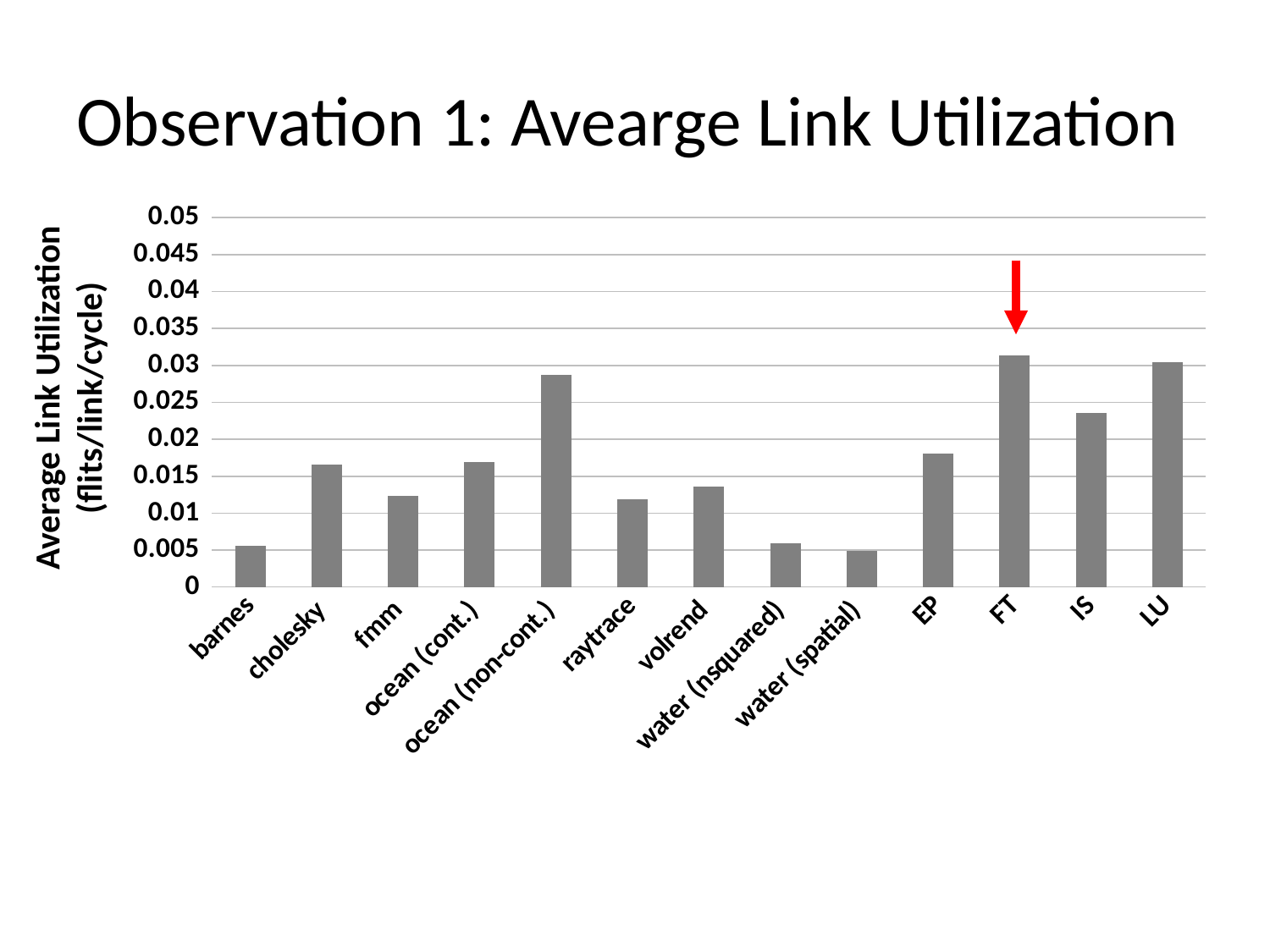
Which category does the red arrow point to? FT How many categories are plotted along the x axis? 13 Is the value for ocean (non-cont.) greater or less than 0.025? greater Is the value for IS greater or less than 0.02? greater Is the value for fmm greater or less than 0.015? less What is the label of the y axis? Average Link Utilization (flits/link/cycle) What kind of chart is shown on the slide? bar chart Which has the larger value, ocean (non-cont.) or cholesky? ocean (non-cont.) Which has the larger value, EP or water (nsquared)? EP